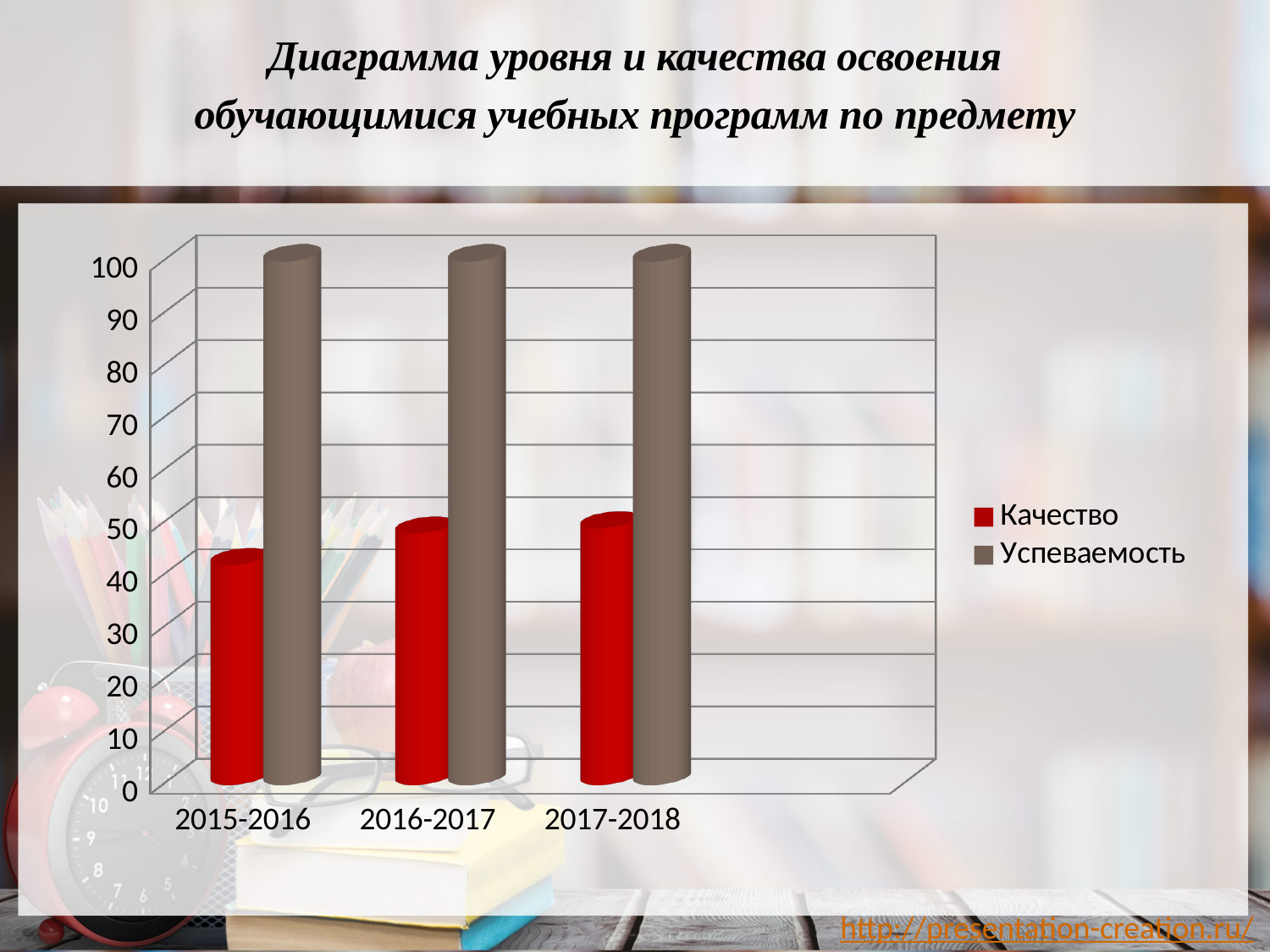
In which year is the Качество value lowest? 2015-2016 What kind of chart is shown on the slide? bar chart Does the Качество series rise or fall from 2015-2016 to 2017-2018? rise For 2015-2016, which is larger: Качество or Успеваемость? Успеваемость Is the value of Успеваемость for 2016-2017 greater or less than 90? greater What are the two series named in the legend? Качество, Успеваемость Which series is shown in red? Качество Is the value of Качество for 2017-2018 greater or less than 60? less How many academic-year categories are shown on the x axis? 3 Is the value of Качество for 2015-2016 greater or less than 30? greater How many series does the legend list? 2